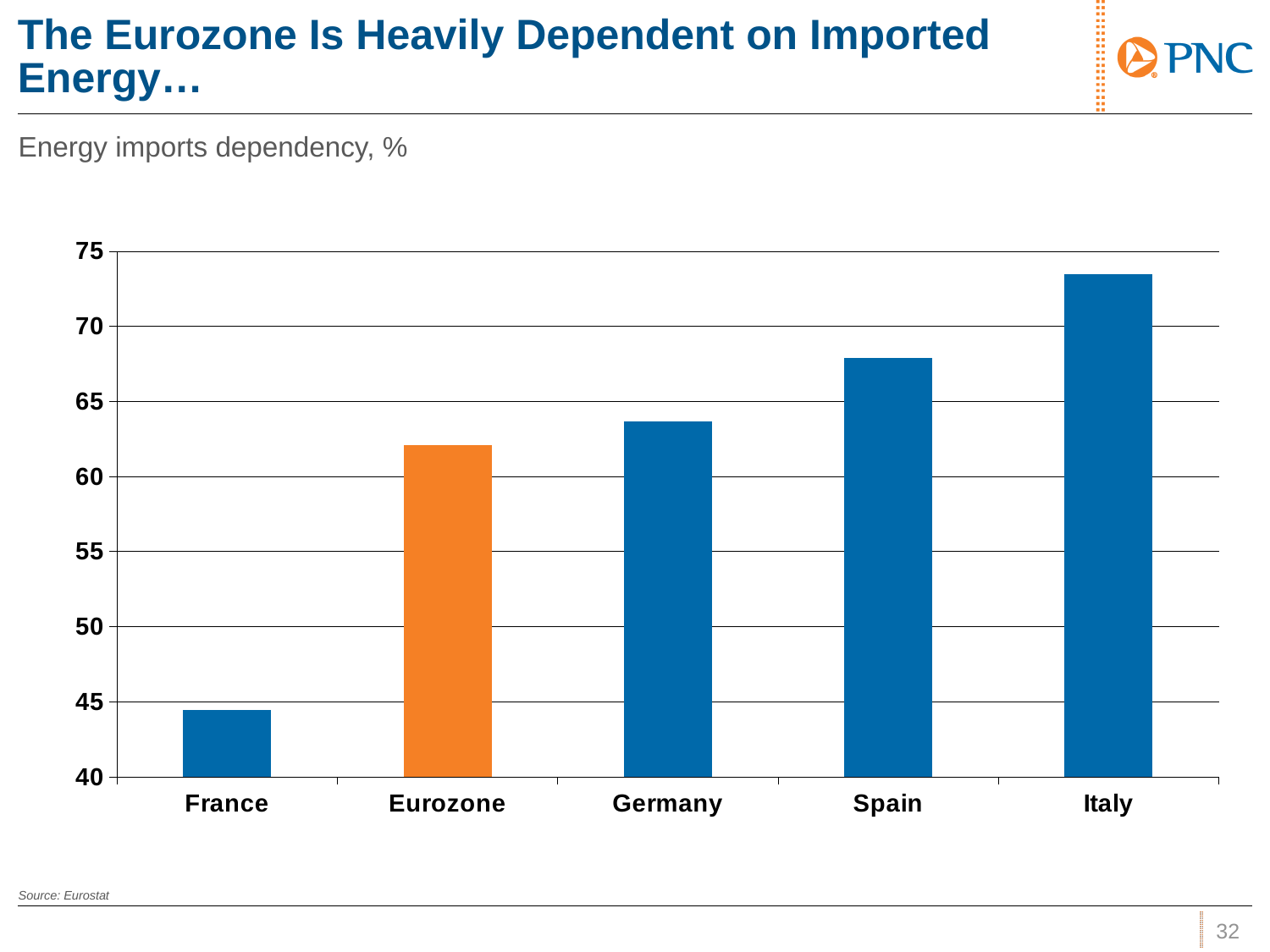
Which category has the lowest energy imports dependency? France Is the value for Eurozone greater or less than 60? greater Is the value for Italy greater or less than 70? greater Which category has the highest energy imports dependency? Italy Is the value for France greater or less than 50? less Which bar is coloured orange rather than blue? Eurozone Which has a higher energy imports dependency, Spain or Germany? Spain How many categories are shown on the x axis of the chart? 5 What kind of chart is shown on the slide? Bar chart Do the values rise or fall moving from left to right along the x axis? Rise